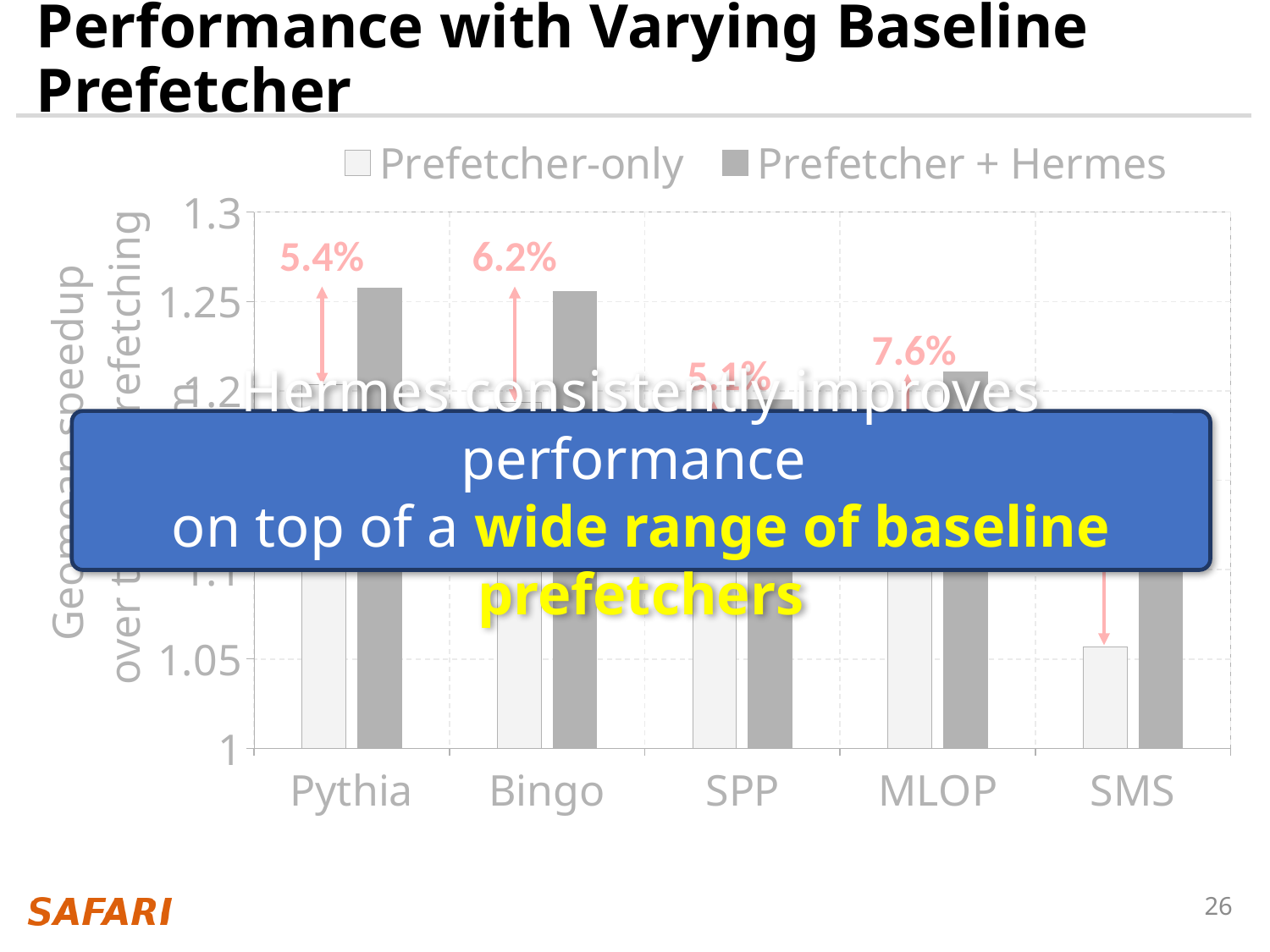
What speedup improvement percentage is annotated above the MLOP bars? 7.6% What are the two series named in the chart legend? Prefetcher-only and Prefetcher + Hermes Which has the larger annotated improvement percentage, Pythia or Bingo? Bingo What speedup improvement percentage is annotated above the Pythia bars? 5.4% What speedup improvement percentage is annotated above the Bingo bars? 6.2% Is the Prefetcher + Hermes value for Pythia greater or less than 1.25? greater Which baseline prefetcher has the lowest Prefetcher-only speedup? SMS How many series does the chart legend list? 2 Is the Prefetcher + Hermes value for MLOP greater or less than 1.2? greater What speedup improvement percentage is annotated above the SPP bars? 5.1% How many baseline prefetchers are shown along the x axis of the chart? 5 What kind of chart is shown on the slide? bar chart